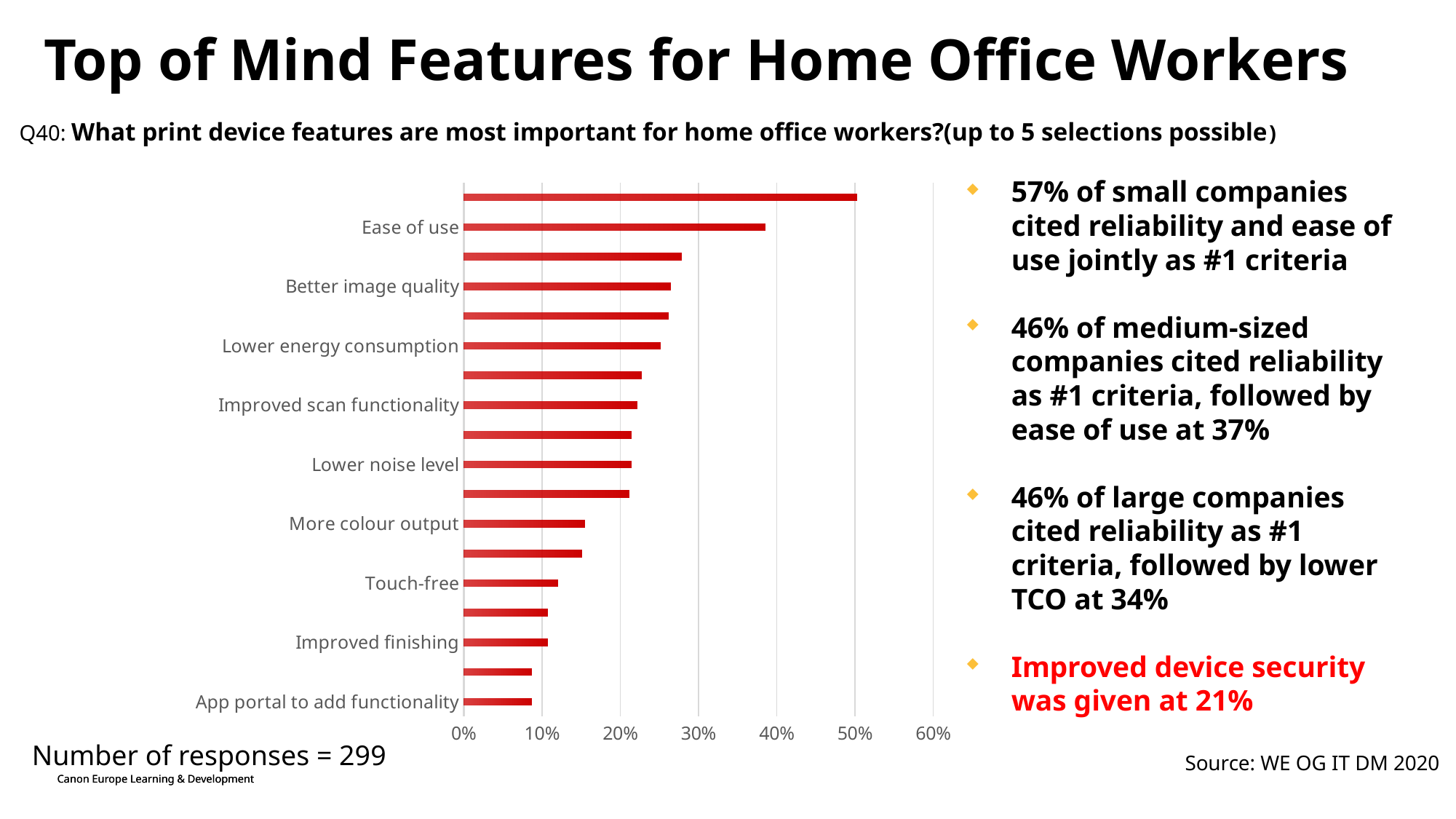
Is the value for Ease of use greater or less than 40%? less Is the value for Lower energy consumption greater or less than 30%? less Is the value for App portal to add functionality greater or less than 10%? less What kind of chart is shown on the slide? bar chart What is the highest tick value shown on the horizontal axis? 60% Do the bar values increase or decrease going from the top of the chart to the bottom? decrease Which has the larger value, Ease of use or Better image quality? Ease of use Of the labelled categories, which has the lowest value? App portal to add functionality Which has the larger value, Touch-free or App portal to add functionality? Touch-free